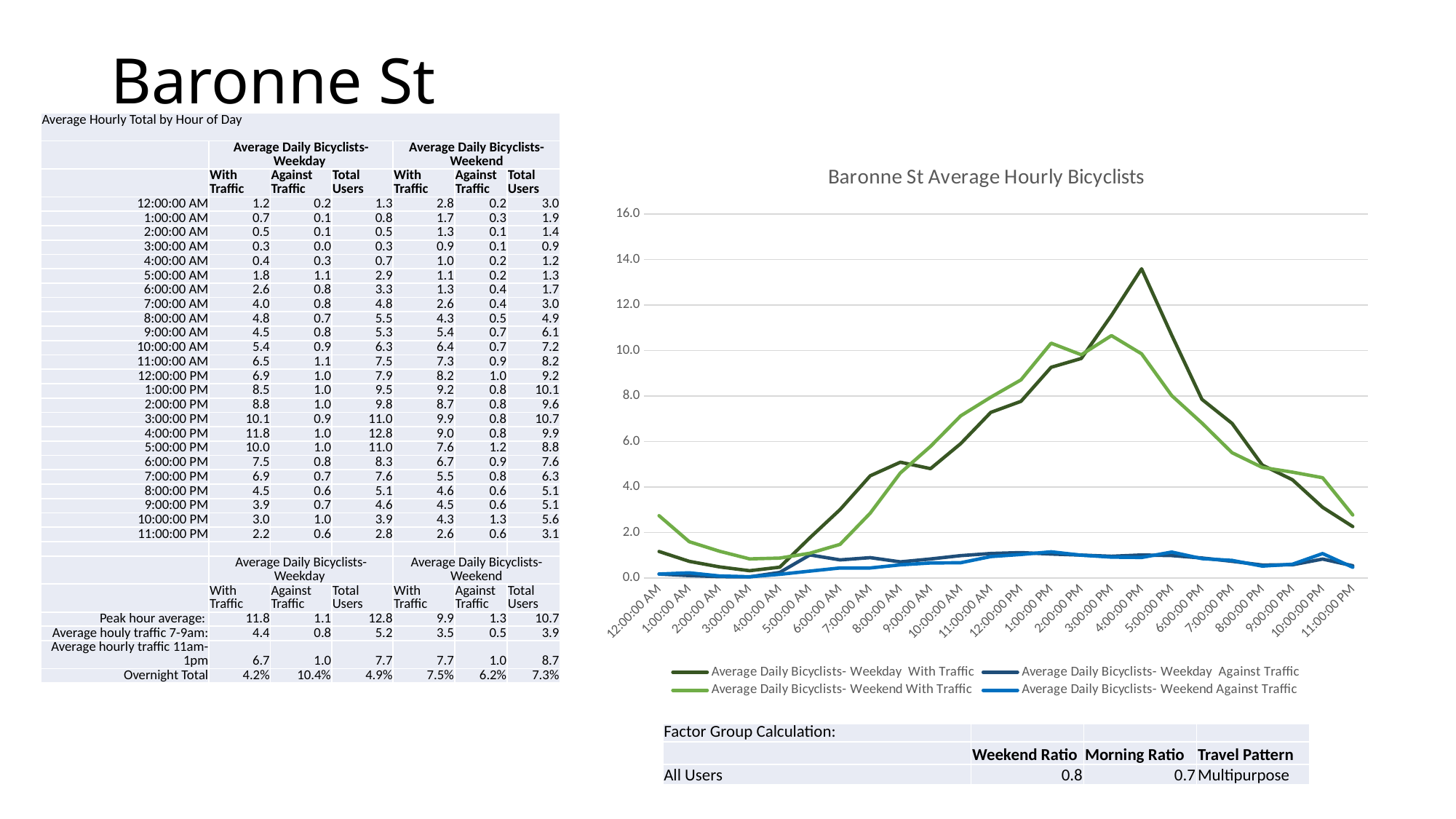
Does the Average Daily Bicyclists- Weekday With Traffic line rise or fall from 4:00:00 PM to 11:00:00 PM? fall What is the title of the chart? Baronne St Average Hourly Bicyclists How many hourly points are plotted along the x axis of the chart? 24 How many series does the chart legend list? 4 Is the value for Average Daily Bicyclists- Weekday With Traffic at 11:00:00 PM greater or less than 4.0? less Is the value for Average Daily Bicyclists- Weekday With Traffic at 4:00:00 PM greater or less than 12.0? greater What kind of chart is shown on the slide? line chart At 12:00:00 AM, which is higher: Average Daily Bicyclists- Weekend With Traffic or Average Daily Bicyclists- Weekday With Traffic? Average Daily Bicyclists- Weekend With Traffic At 4:00:00 PM, which is higher: Average Daily Bicyclists- Weekday With Traffic or Average Daily Bicyclists- Weekend With Traffic? Average Daily Bicyclists- Weekday With Traffic Is the value for Average Daily Bicyclists- Weekday Against Traffic at 3:00:00 PM greater or less than 2.0? less At which hour does the Average Daily Bicyclists- Weekday With Traffic line reach its highest value? 4:00:00 PM